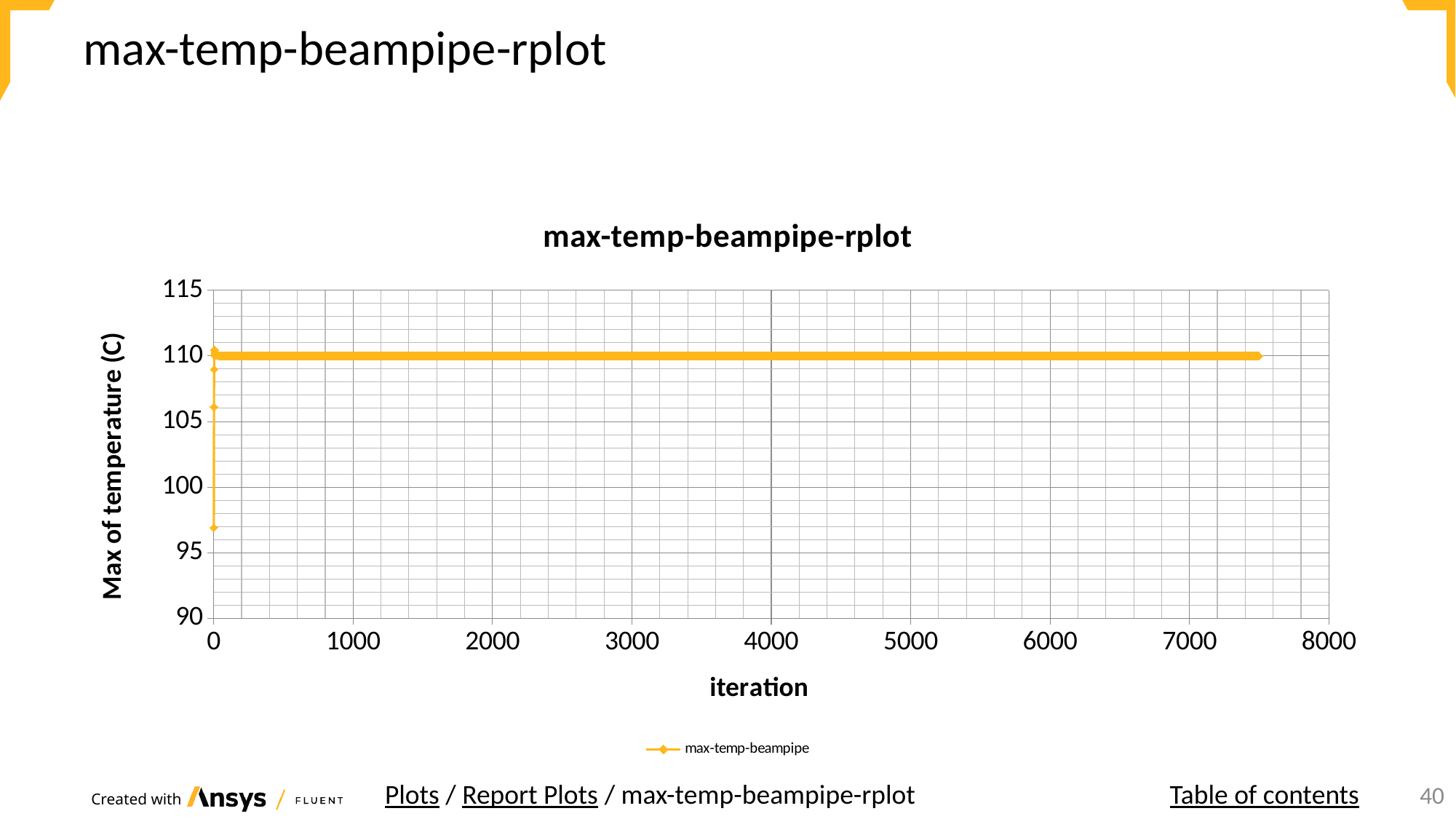
What is the title of the chart? max-temp-beampipe-rplot Is the value for max-temp-beampipe at iteration 6000 greater or less than 100? greater Over the first few iterations, does the max-temp-beampipe value rise or fall? rise Is the value for max-temp-beampipe at iteration 2000 greater or less than 115? less What kind of chart is shown on the slide? line chart What is the label of the y axis? Max of temperature (C) Between iteration 1000 and iteration 7000, does the max-temp-beampipe value rise, fall, or stay flat? stay flat What is the largest tick value shown on the x axis? 8000 How many series does the legend list? 1 Is the lowest plotted value for max-temp-beampipe greater or less than 100? less